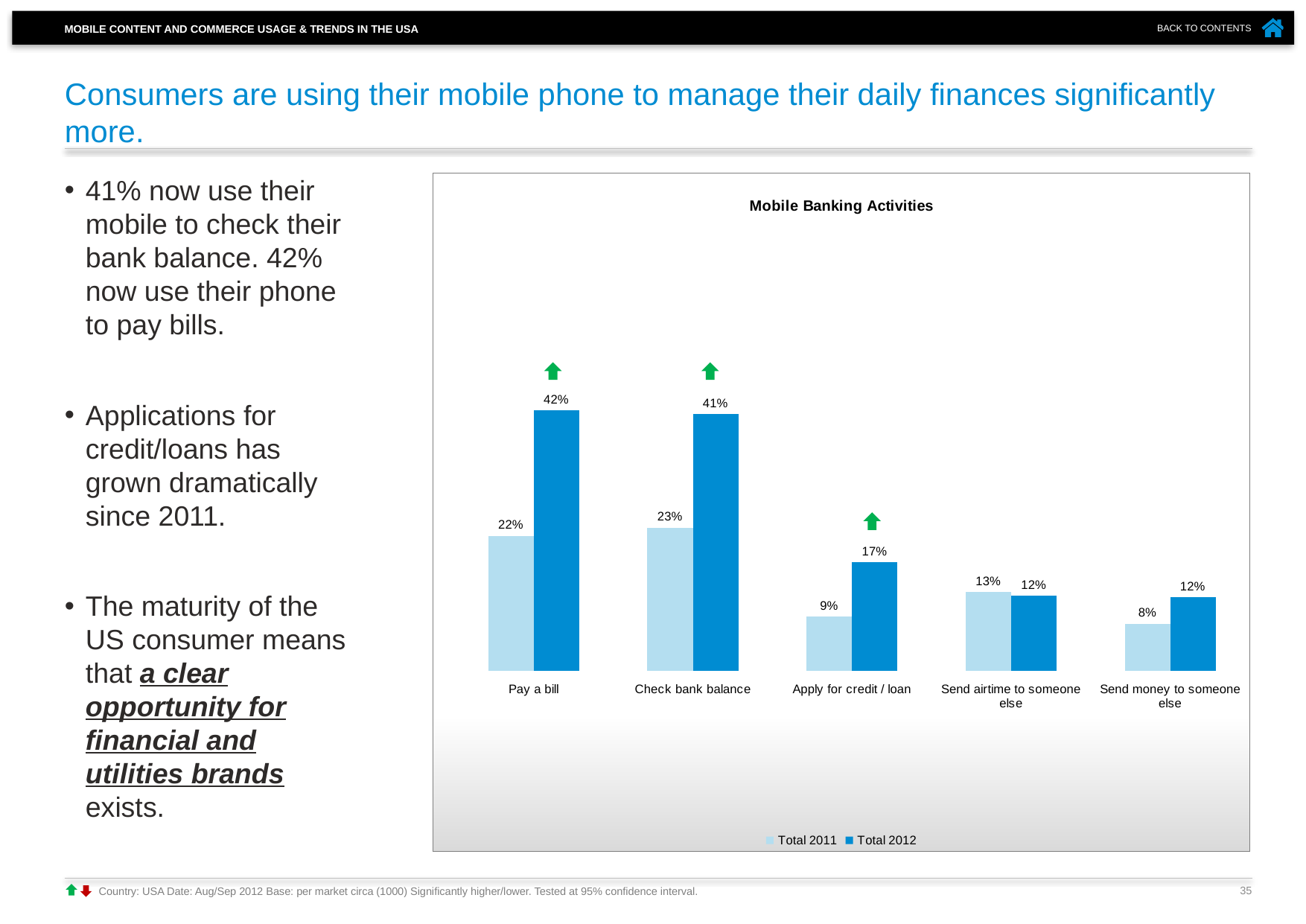
Which is larger for Send airtime to someone else: Total 2011 or Total 2012? Total 2011 Which category has the highest Total 2012 value? Pay a bill What is the Total 2012 value for Apply for credit / loan? 17% What is the Total 2012 value for Pay a bill? 42% How many series does the legend list? 2 What is the Total 2011 value for Check bank balance? 23% Which category has the lowest Total 2011 value? Send money to someone else What kind of chart is shown? Bar chart What is the title of the chart? Mobile Banking Activities How many categories are shown on the x axis? 5 What is the Total 2011 value for Send money to someone else? 8% What is the difference between the Total 2012 and Total 2011 values for Pay a bill? 20%